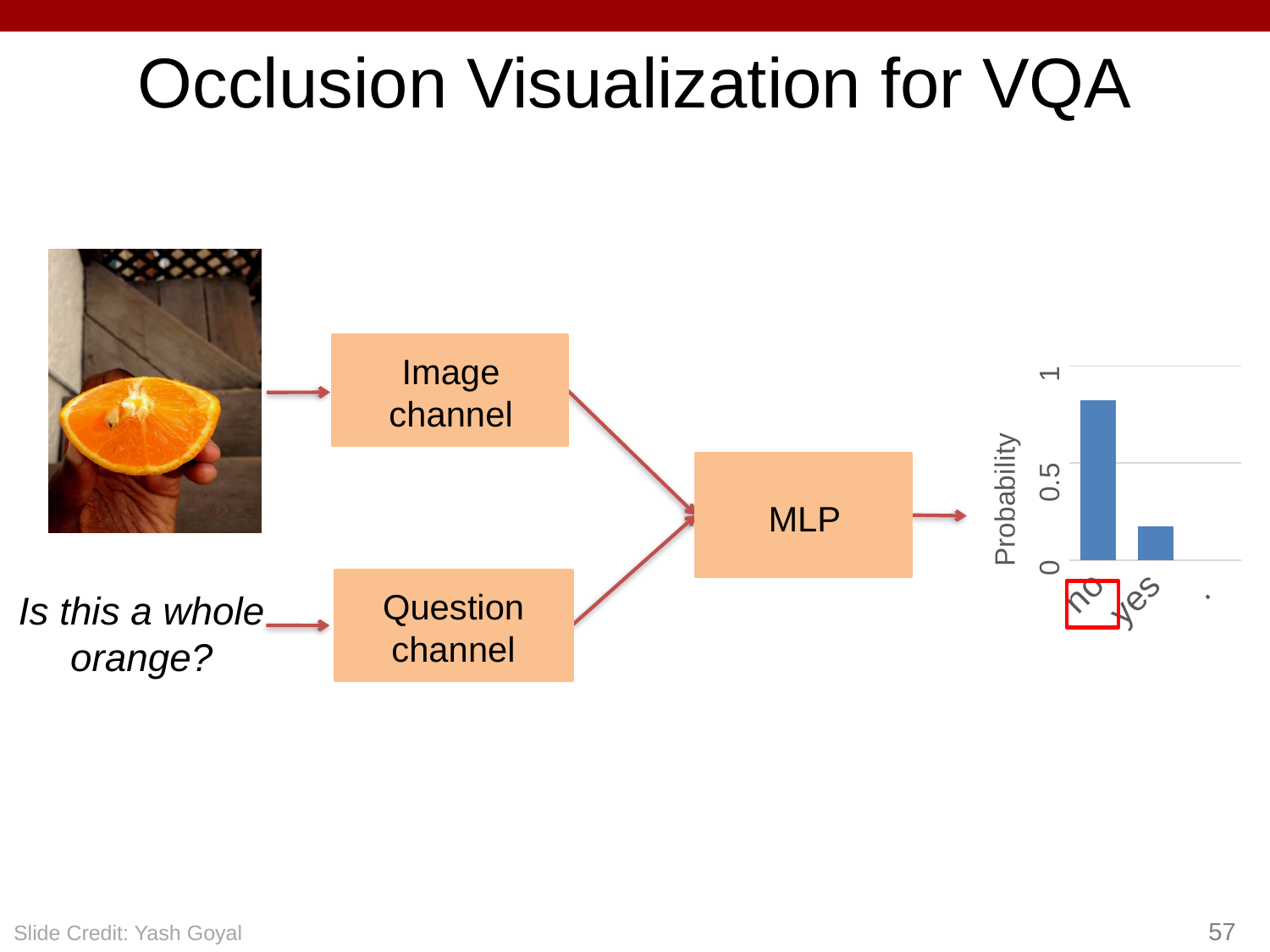
Is the probability for "no" greater or less than 0.5? greater Which category has the highest probability in the bar chart? no Is the probability for "yes" greater or less than 0.5? less Which category has the lowest probability in the bar chart? yes Which has a larger probability in the bar chart, "no" or "yes"? no What is the label of the vertical axis of the bar chart? Probability How many categories are plotted in the bar chart? 2 Which category label in the bar chart is outlined with a red box? no What kind of chart is shown on the right of the slide? bar chart